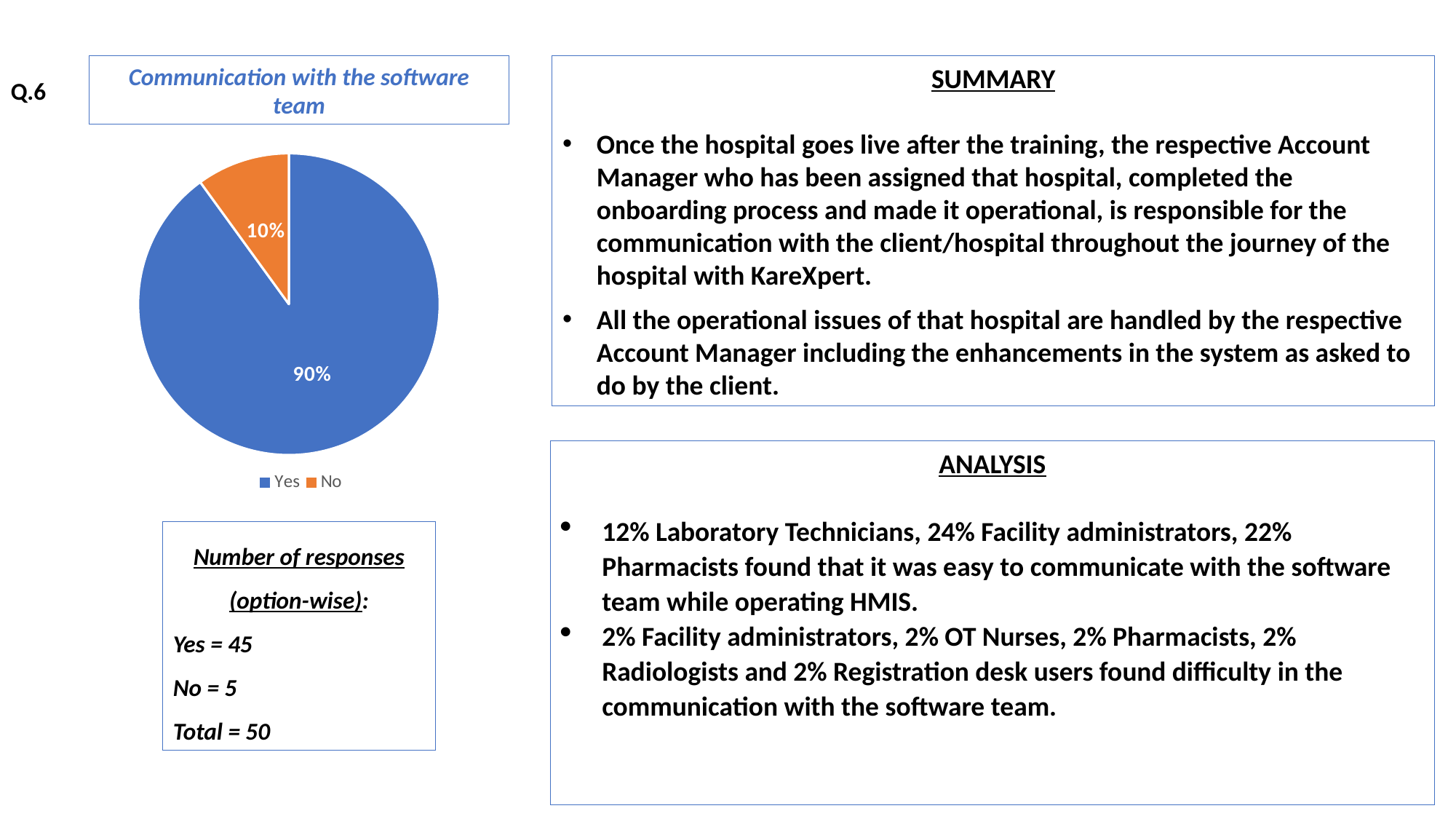
What colour is the "No" slice in the pie chart? orange Which category has the smallest share of the pie? No Which category has the largest share of the pie? Yes How many slices does the pie chart have? 2 How many entries does the legend list? 2 What kind of chart is shown on the slide? pie chart Is the share for "Yes" greater or less than 50%? greater What is the difference in percentage points between the "Yes" and "No" slices? 80 What percentage of the pie is labelled "Yes"? 90% What percentage of the pie is labelled "No"? 10% Which slice is larger, "Yes" or "No"? Yes What is the title of the chart? Communication with the software team